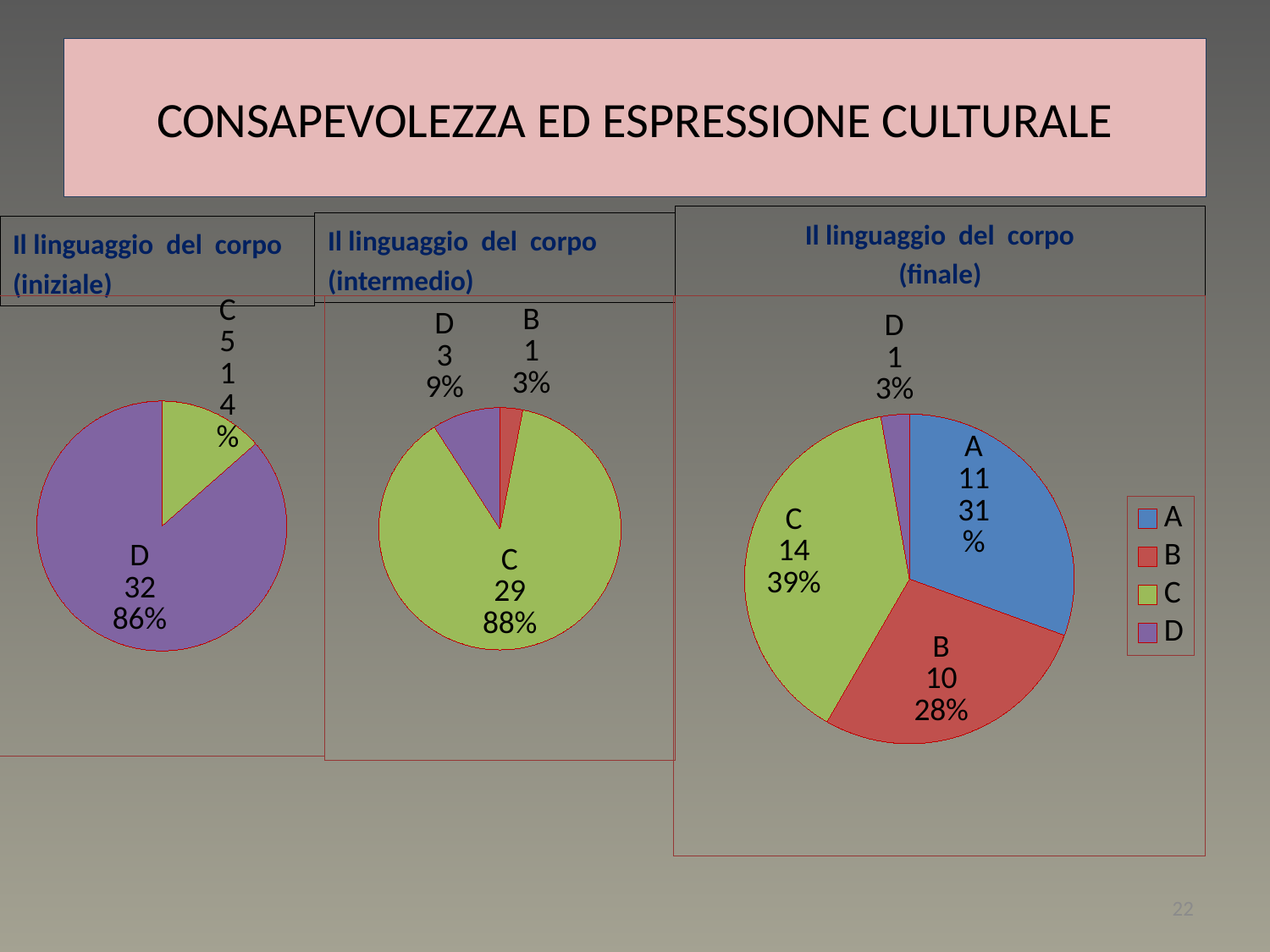
In the 'Il linguaggio del corpo (intermedio)' chart, which category has the smallest slice? B In the 'Il linguaggio del corpo (finale)' chart, which category has the largest slice? C In the 'Il linguaggio del corpo (iniziale)' chart, what percentage share does category C have? 14% In the 'Il linguaggio del corpo (finale)' chart, what percentage share does category B have? 28% How many slices does the 'Il linguaggio del corpo (finale)' pie chart have? 4 In the 'Il linguaggio del corpo (intermedio)' chart, what percentage share does category D have? 9% What type of chart is used for 'Il linguaggio del corpo (iniziale)'? Pie chart In the 'Il linguaggio del corpo (iniziale)' chart, what is the count for category D? 32 In the 'Il linguaggio del corpo (finale)' chart, what is the count for category A? 11 In the 'Il linguaggio del corpo (finale)' chart, which is larger, the count for A or the count for D? A In the 'Il linguaggio del corpo (intermedio)' chart, what is the count for category C? 29 In the 'Il linguaggio del corpo (finale)' chart, what is the difference between the counts for C and B? 4